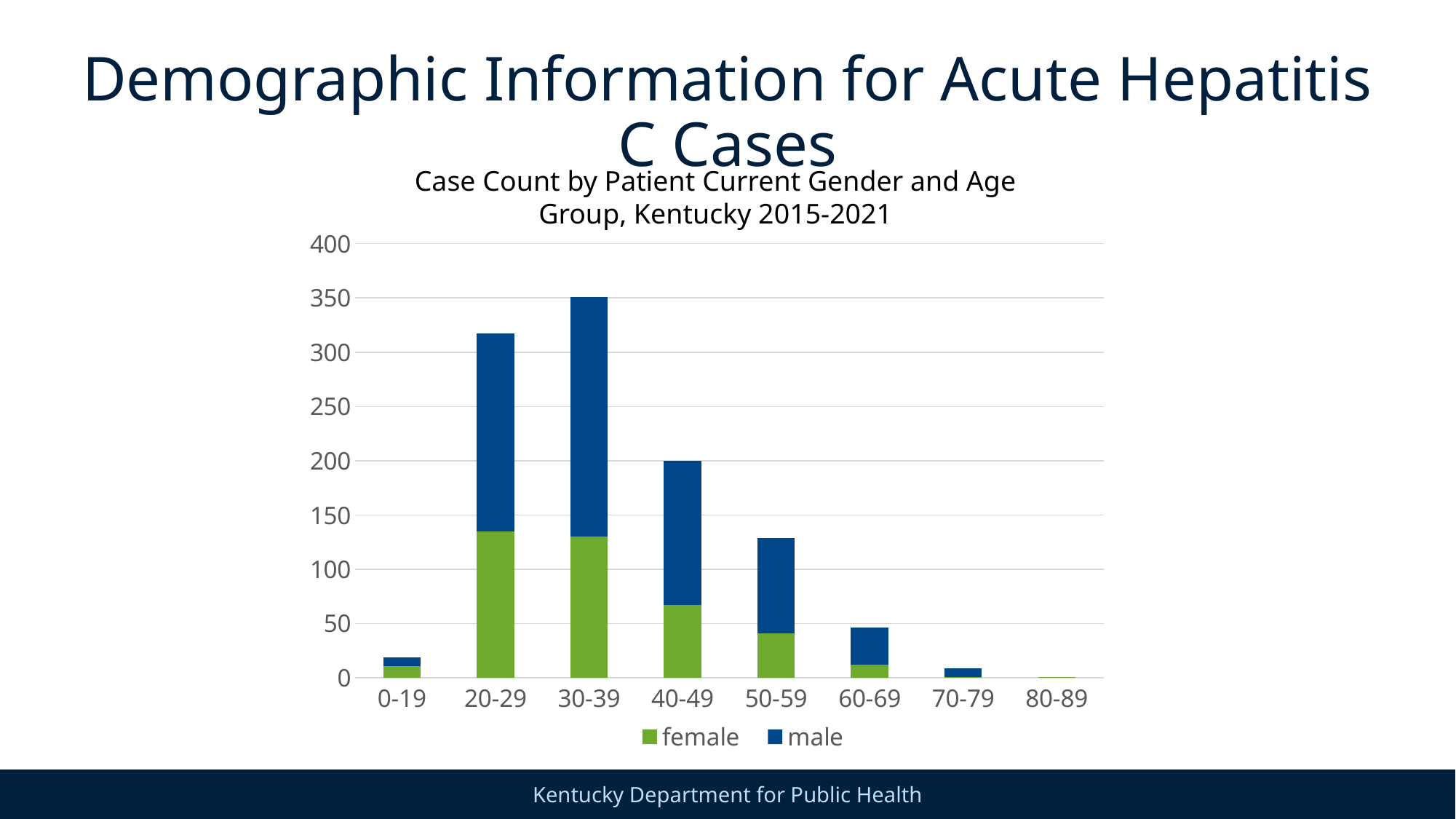
How many series does the legend list? 2 Is the total case count for the 60-69 age group greater or less than 100? less Is the female case count for the 20-29 age group greater or less than 100? greater Which has a larger total case count, the 20-29 age group or the 40-49 age group? 20-29 How many age groups are shown on the x axis? 8 What kind of chart is shown on the slide? Stacked bar chart Is the total case count for the 50-59 age group greater or less than 150? less Which series is shown in green in the legend? female Which age group has the highest total case count? 30-39 Which age group has the lowest total case count? 80-89 From the 30-39 age group onward, do the total case counts rise or fall as age increases? fall